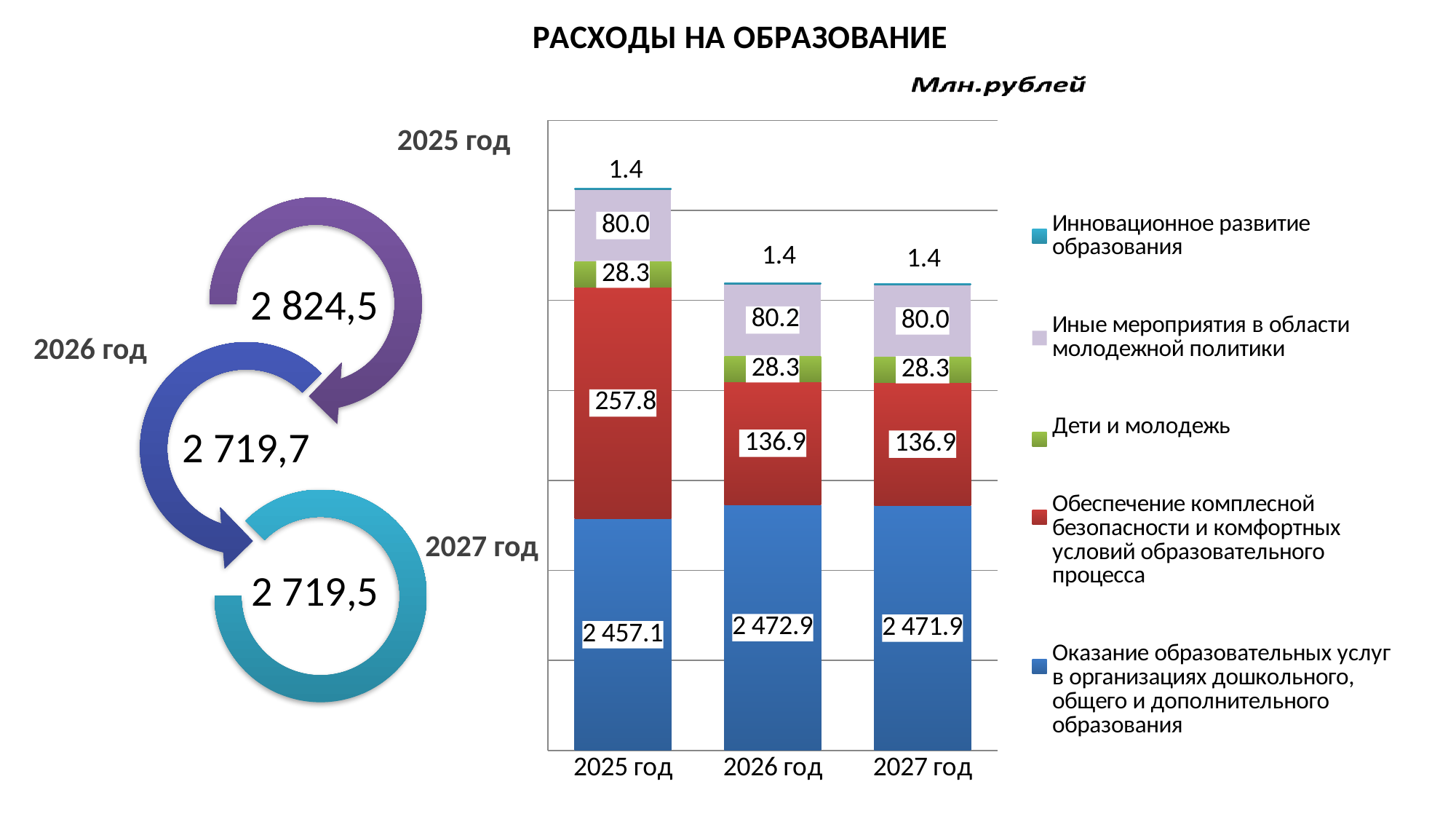
What kind of chart is shown on the slide? Stacked bar chart What is the value for «Иные мероприятия в области молодежной политики» in 2027 год? 80.0 How many years (categories) are shown on the x axis of the chart? 3 What is the value for «Дети и молодежь» in 2026 год? 28.3 What is the value for «Инновационное развитие образования» in 2027 год? 1.4 What is the value for «Оказание образовательных услуг в организациях дошкольного, общего и дополнительного образования» in 2026 год? 2 472.9 By how much does the value for «Оказание образовательных услуг в организациях дошкольного, общего и дополнительного образования» in 2026 год exceed that in 2025 год? 15.8 In which year is the value for «Обеспечение комплесной безопасности и комфортных условий образовательного процесса» highest? 2025 год How many series does the chart legend list? 5 Which year has the larger value for «Иные мероприятия в области молодежной политики», 2025 год or 2026 год? 2026 год What is the value for «Обеспечение комплесной безопасности и комфортных условий образовательного процесса» in 2025 год? 257.8 What is the difference between the 2025 год and 2026 год values for «Обеспечение комплесной безопасности и комфортных условий образовательного процесса»? 120.9